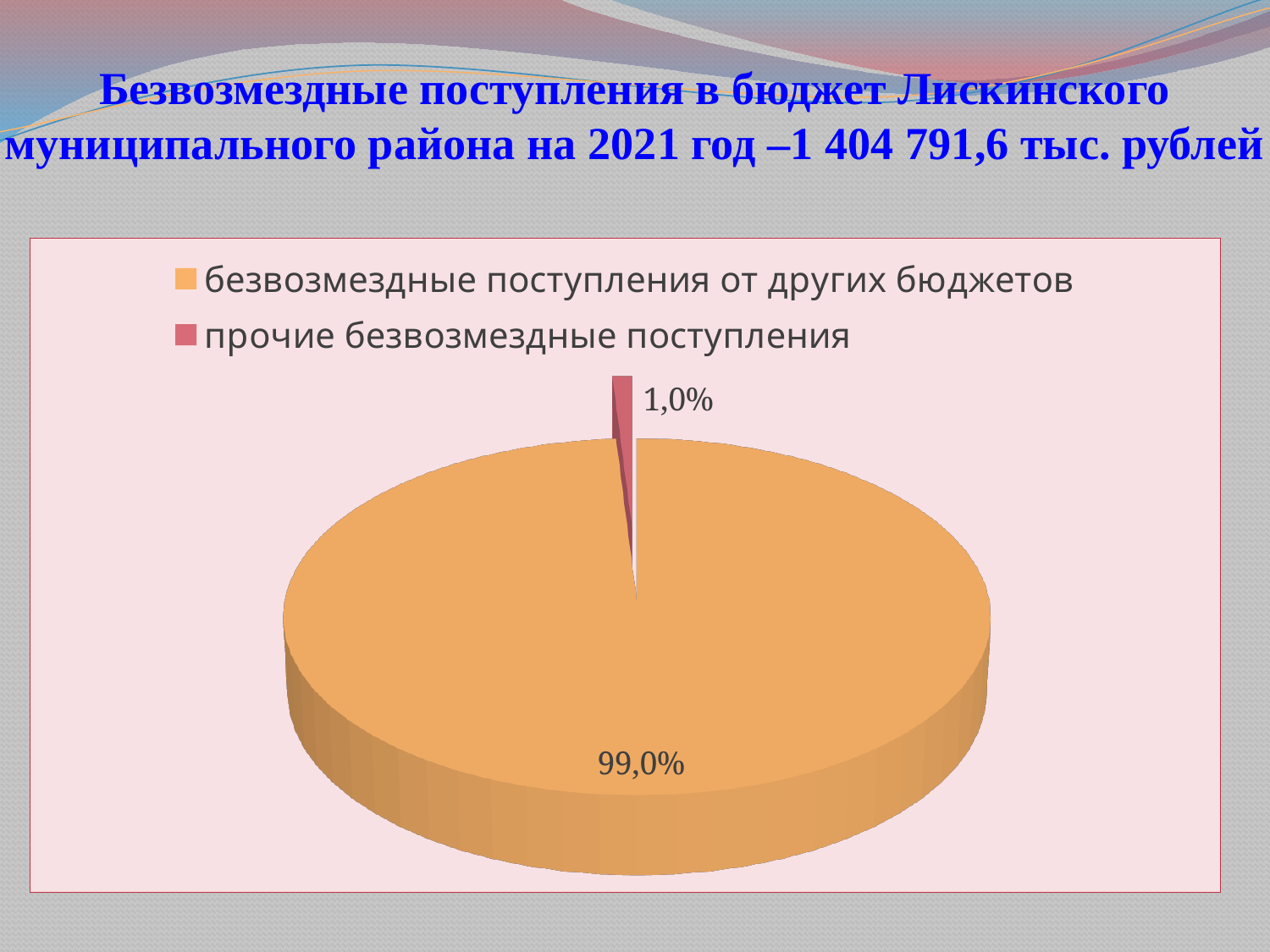
What share of the pie does "безвозмездные поступления от других бюджетов" take? 99,0% Which is larger: the slice for "прочие безвозмездные поступления" or the slice for "безвозмездные поступления от других бюджетов"? безвозмездные поступления от других бюджетов Which category has the largest slice of the pie? безвозмездные поступления от других бюджетов How many slices does the pie chart have? 2 What total amount of gratuitous receipts for 2021 is stated in the slide title? 1 404 791,6 тыс. рублей What kind of chart is shown on the slide? pie chart What colour is the slice for "прочие безвозмездные поступления"? red Which category has the smallest slice of the pie? прочие безвозмездные поступления What share of the pie does "прочие безвозмездные поступления" take? 1,0% What is the difference in percentage points between the two slices of the pie? 98,0% How many entries does the legend list? 2